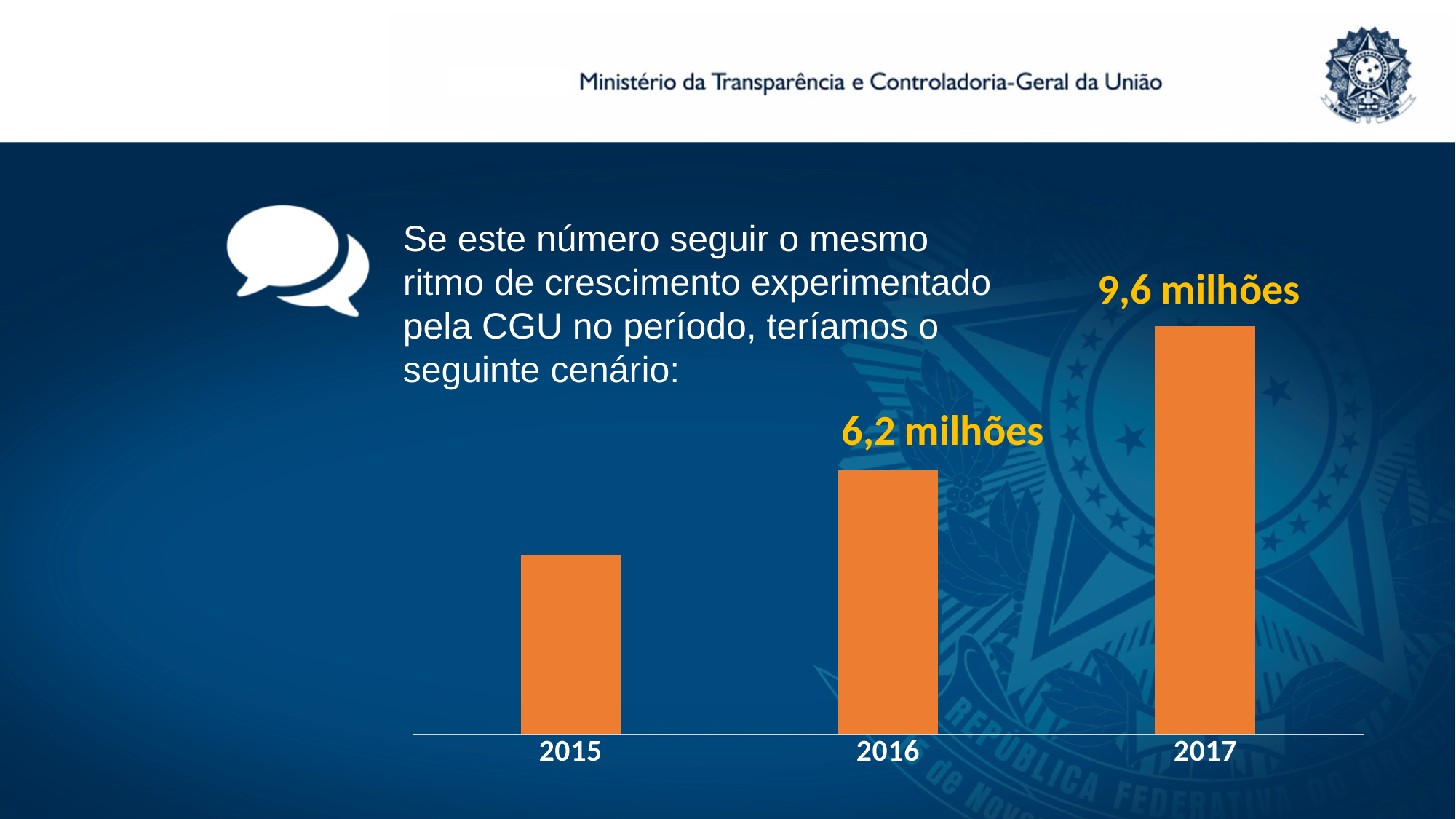
Which is larger, the bar for 2015 or the bar for 2016? 2016 What value is shown for 2017? 9,6 milhões What kind of chart is shown on the slide? Bar chart Do the values rise or fall from 2015 to 2017? Rise Which year has the highest bar? 2017 What colour are the bars in the chart? Orange How many years are shown on the x axis? 3 Which year has the lowest bar? 2015 What is the difference between the values for 2017 and 2016? 3,4 milhões Which is larger, the value for 2016 or the value for 2017? 2017 Which year's bar has no data label printed above it? 2015 What value is shown for 2016? 6,2 milhões